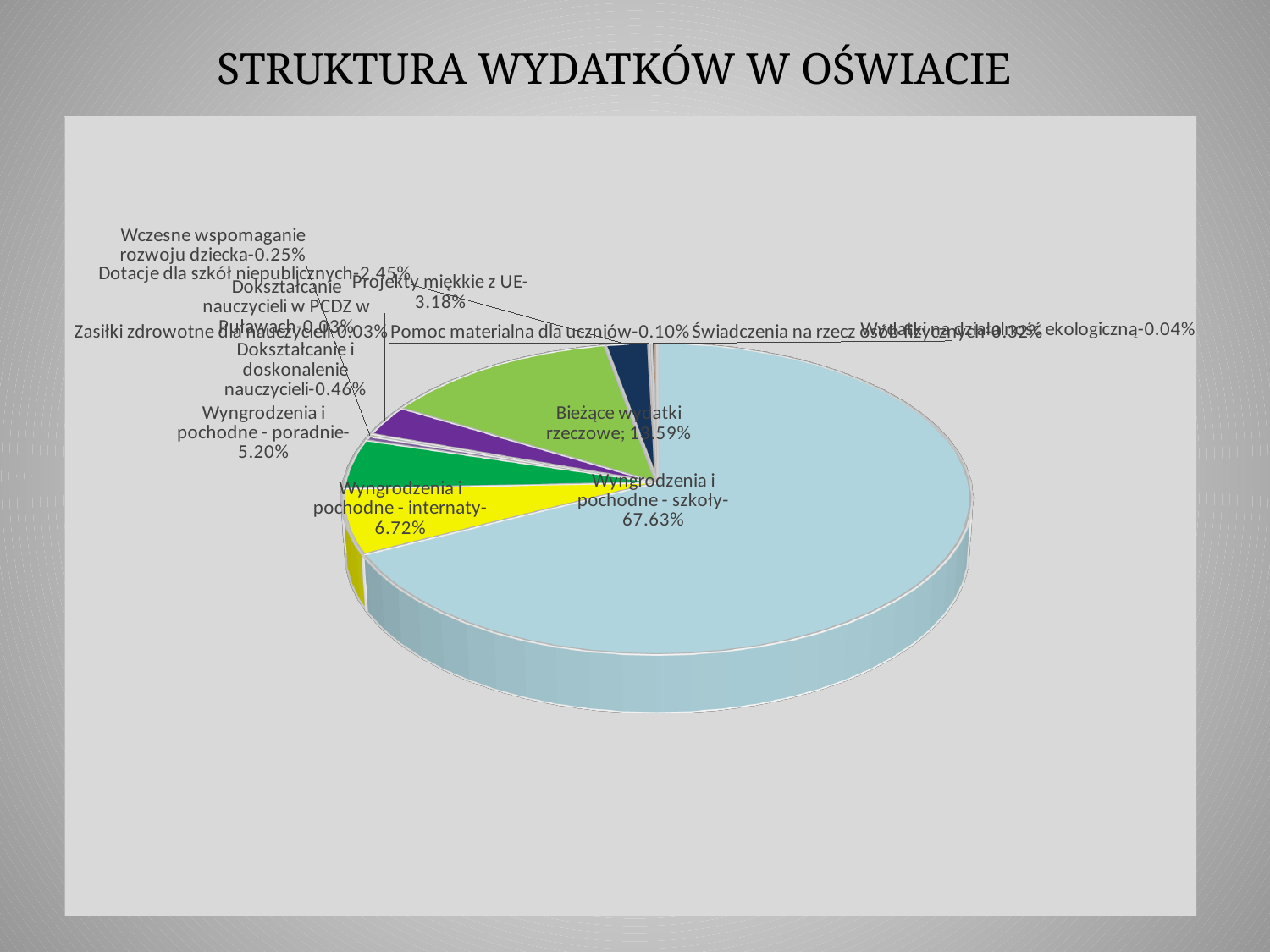
What is the value for 'Projekty miękkie z UE'? 3.18% What is the value for 'Dotacje dla szkół niepublicznych'? 2.45% Which category has the largest share of the pie? Wyngrodzenia i pochodne - szkoły What share of the pie does 'Wynagrodzenia i pochodne - szkoły' have? 67.63% What is the title of the slide? STRUKTURA WYDATKÓW W OŚWIACIE What is the difference between 'Wynagrodzenia i pochodne - internaty' and 'Wynagrodzenia i pochodne - poradnie'? 1.52% Which is larger, 'Wynagrodzenia i pochodne - internaty' or 'Wynagrodzenia i pochodne - poradnie'? Wyngrodzenia i pochodne - internaty What is the value for 'Wynagrodzenia i pochodne - poradnie'? 5.20% What is the value for 'Wczesne wspomaganie rozwoju dziecka'? 0.25% What kind of chart is shown on the slide? pie chart What is the value for 'Dokształcanie i doskonalenie nauczycieli'? 0.46% What is the value for 'Wynagrodzenia i pochodne - internaty'? 6.72%